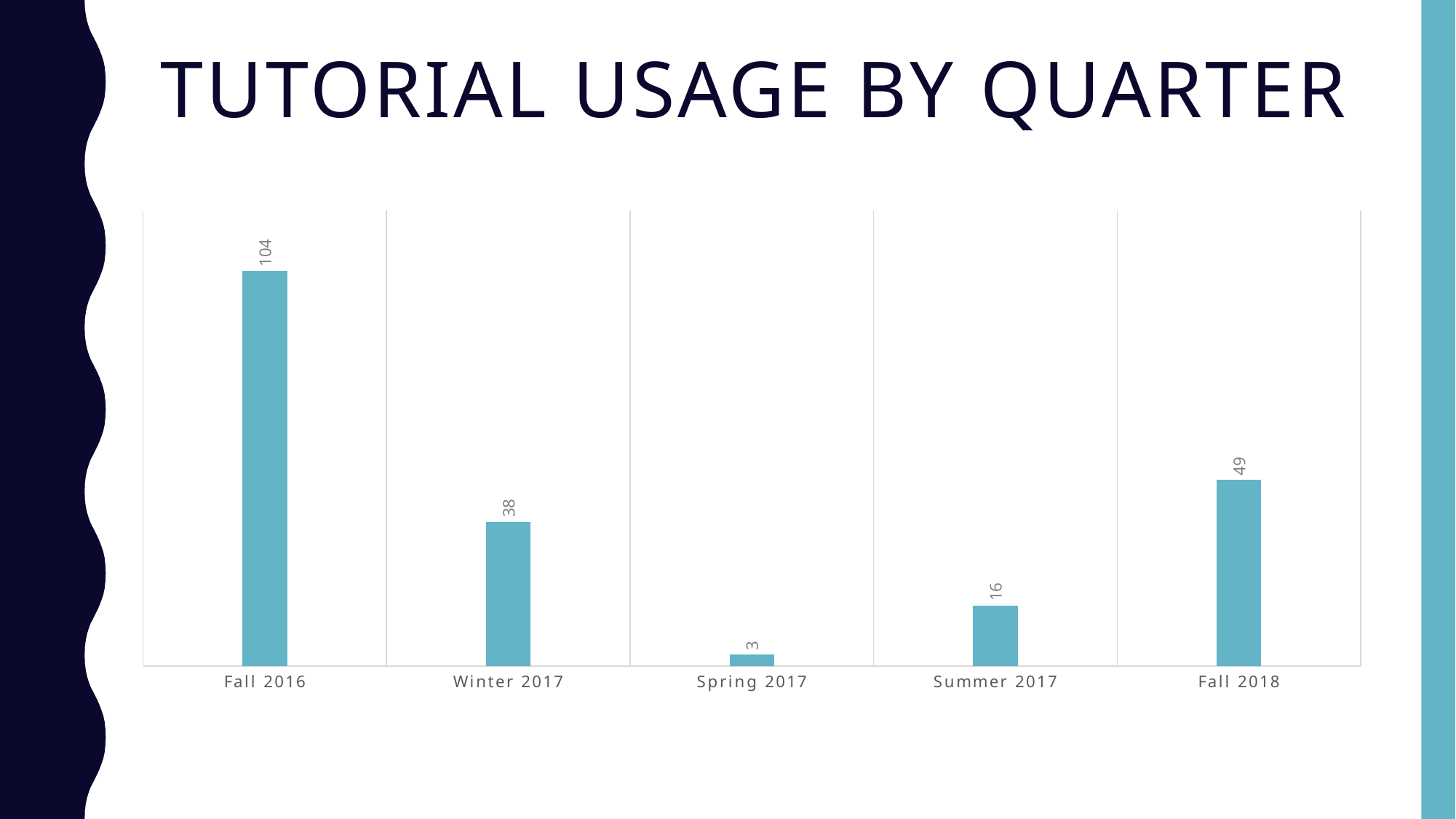
What is the title of the slide? Tutorial Usage by Quarter What is the value for Winter 2017? 38 Which is larger, the value for Winter 2017 or the value for Summer 2017? Winter 2017 Which quarter has the highest value? Fall 2016 What is the value for Fall 2018? 49 Which quarter has the lowest value? Spring 2017 What kind of chart is shown on the slide? Bar chart What is the difference between the values for Fall 2016 and Fall 2018? 55 How many quarters are shown on the chart? 5 What is the value for Spring 2017? 3 What is the value for Summer 2017? 16 What is the value for Fall 2016? 104